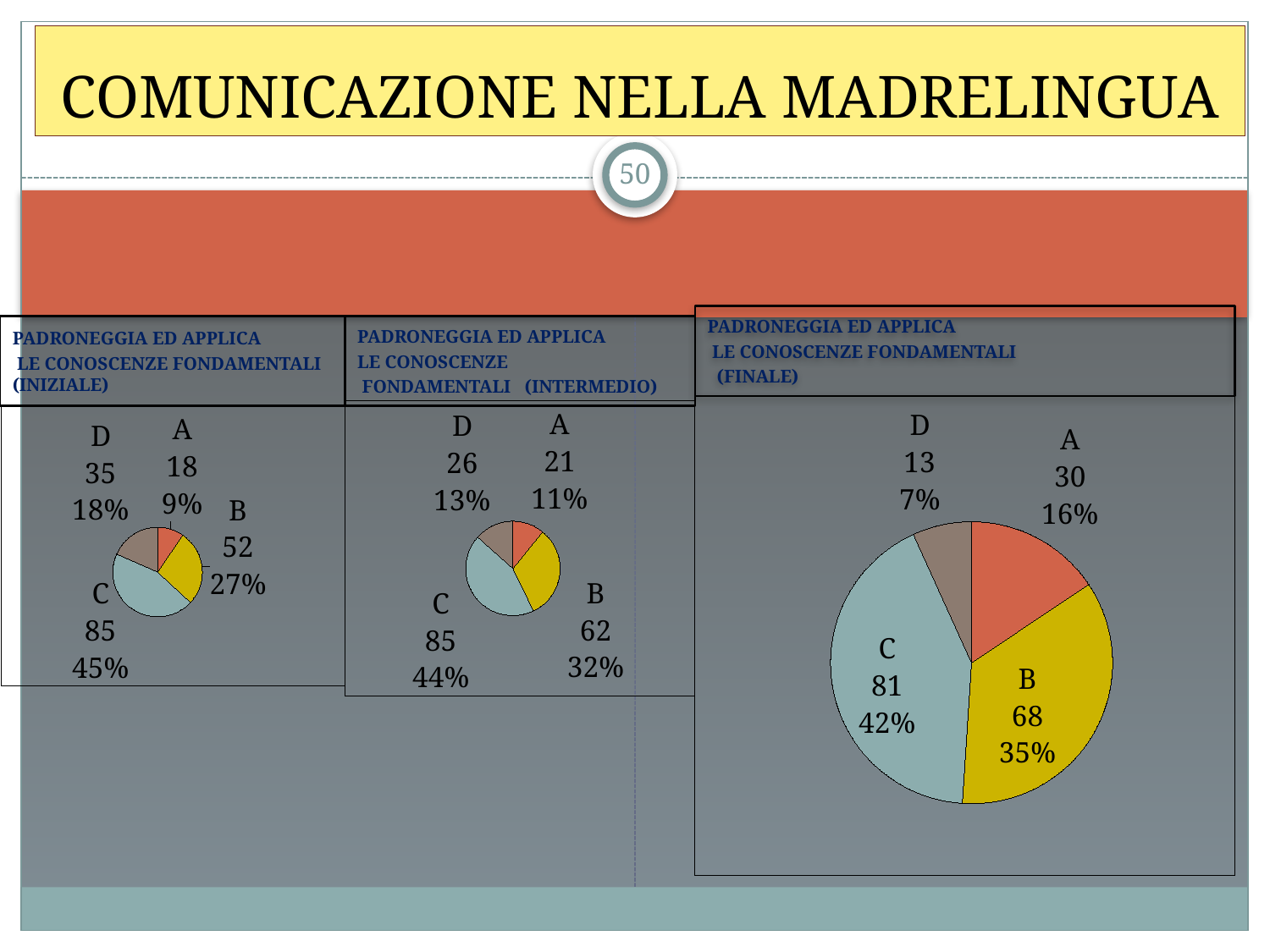
In the FINALE pie chart, what is the value for category B? 68 In the FINALE pie chart, what share of the pie does category D represent? 7% How many slices does the FINALE pie chart have? 4 In the INIZIALE pie chart, which category has the lowest value? A In the FINALE pie chart, which category has the highest value? C In the INTERMEDIO pie chart, what is the value for category D? 26 In the FINALE pie chart, which is larger, the value for A or the value for D? A In the INTERMEDIO pie chart, what share of the pie does category C represent? 44% What kind of chart is used in the INIZIALE panel? Pie chart In the INTERMEDIO pie chart, what is the difference between the values for B and A? 41 In the INIZIALE pie chart, what is the value for category C? 85 In the INIZIALE pie chart, what share of the pie does category B represent? 27%